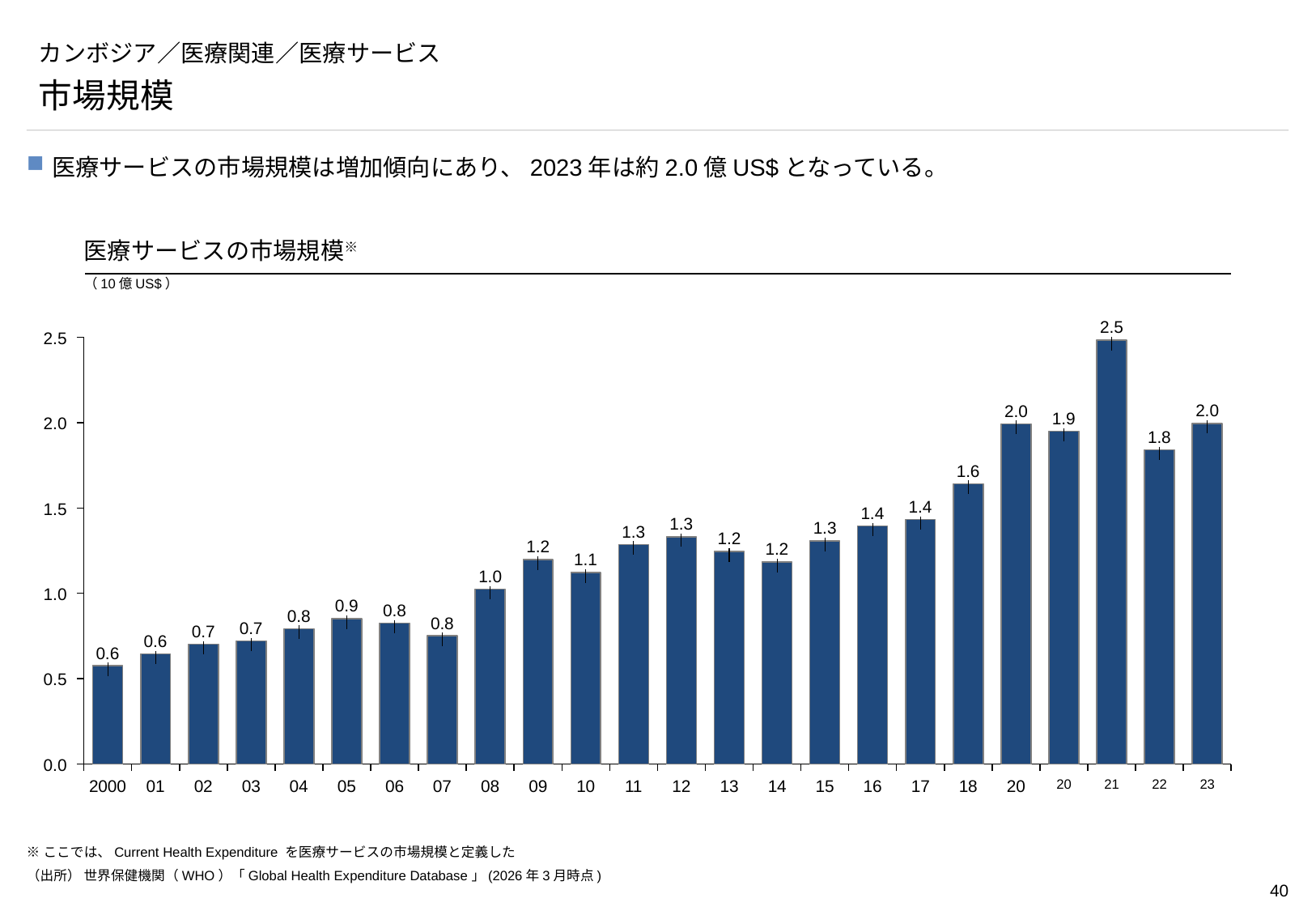
How many bars are plotted in the chart? 24 What is the value for 09 in the chart? 1.2 What is the difference between the values for 21 and 23? 0.5 What is the value for 2000 in the chart? 0.6 What is the value for 23 in the chart? 2.0 Which is larger, the value for 18 or the value for 22? 22 Do the values generally rise or fall from 2000 to 23? rise What is the value for 05 in the chart? 0.9 What unit is shown for the chart's values? 10億US$ What kind of chart is shown on the slide? bar chart Which year has the highest value in the chart? 21 Is the value for 17 greater or less than 1.5? less